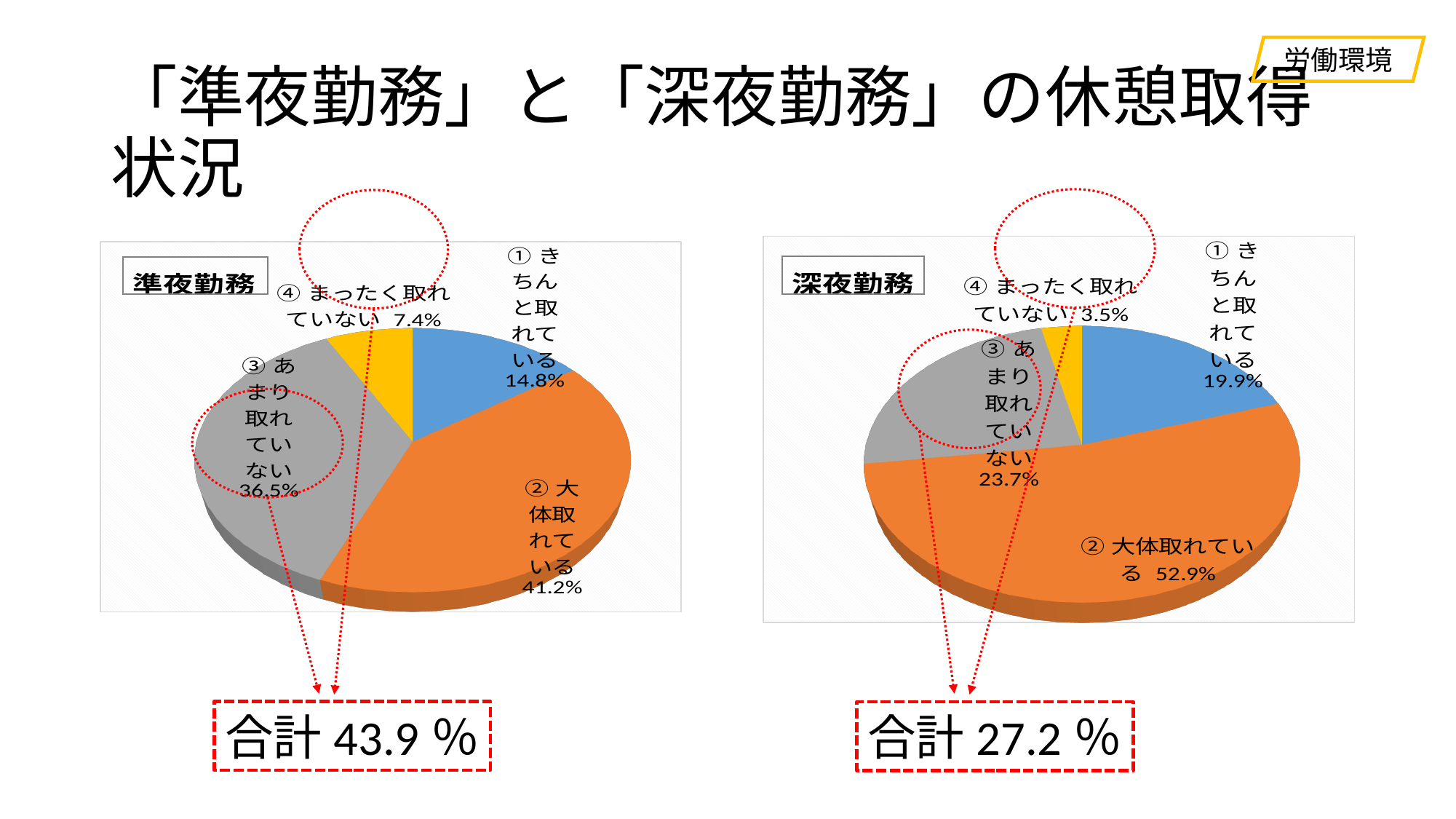
What is the combined share of ③ あまり取れていない and ④ まったく取れていない in the 深夜勤務 chart, as shown in the 合計 box? 27.2% How many categories does the 準夜勤務 pie chart have? 4 In the 準夜勤務 pie chart, what percentage is shown for ④ まったく取れていない? 7.4% What type of chart is used for 深夜勤務? Pie chart Which is larger: ③ あまり取れていない in the 準夜勤務 chart or ③ あまり取れていない in the 深夜勤務 chart? 準夜勤務 (36.5%) In the 準夜勤務 pie chart, which category has the largest share? ② 大体取れている In the 深夜勤務 pie chart, what percentage is shown for ③ あまり取れていない? 23.7% In the 準夜勤務 pie chart, what percentage is shown for ② 大体取れている? 41.2% In the 深夜勤務 pie chart, what percentage is shown for ① きちんと取れている? 19.9% What is the difference between the ② 大体取れている shares in the 深夜勤務 chart and the 準夜勤務 chart? 11.7% In the 深夜勤務 pie chart, which category has the smallest share? ④ まったく取れていない What colour is the ④ まったく取れていない slice in the 準夜勤務 pie chart? Yellow